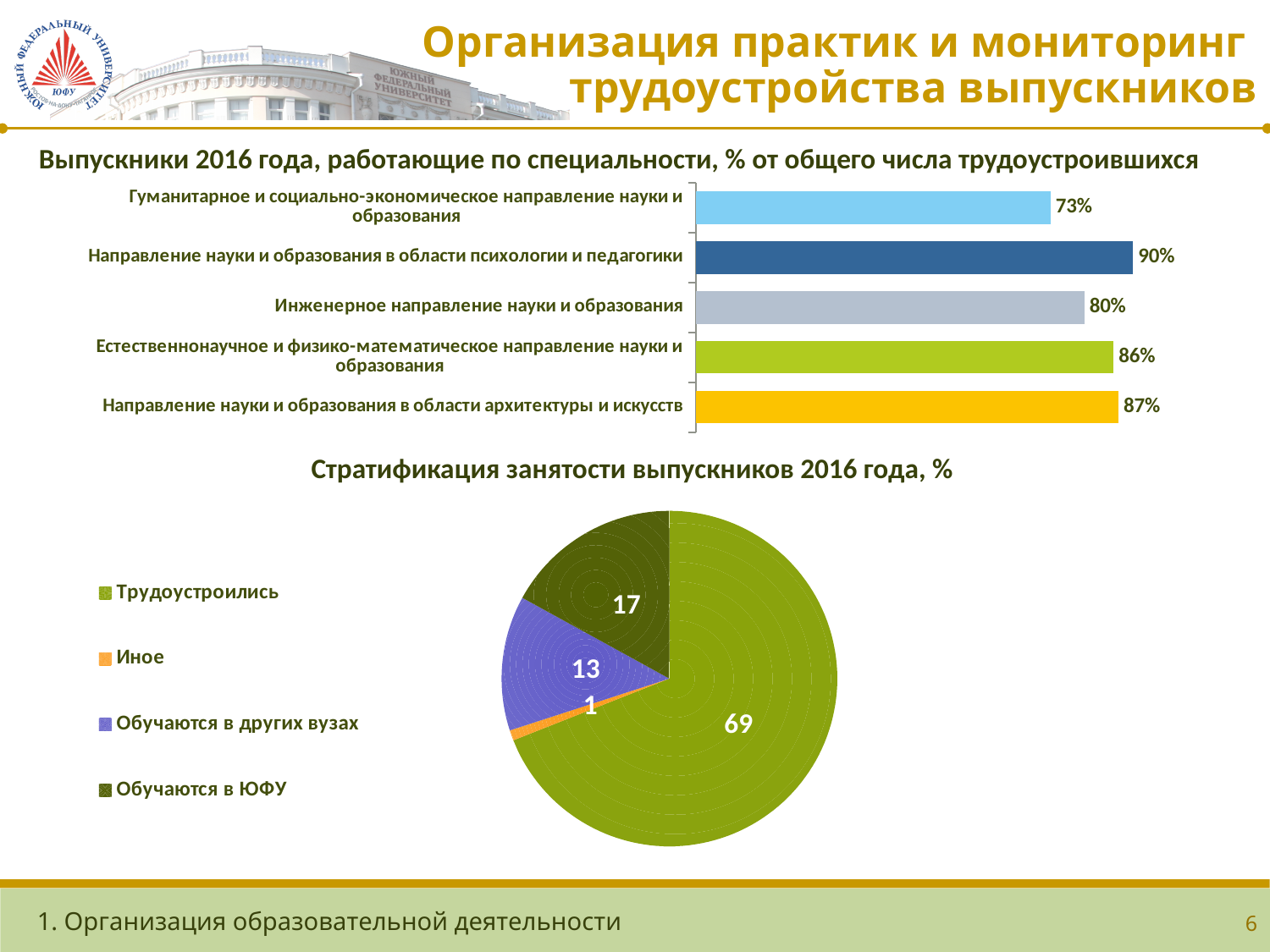
How many entries does the legend of the pie chart 'Стратификация занятости выпускников 2016 года, %' list? 4 In the bar chart 'Выпускники 2016 года, работающие по специальности', what is the value for 'Гуманитарное и социально-экономическое направление науки и образования'? 73% In the pie chart 'Стратификация занятости выпускников 2016 года, %', what is the value for 'Трудоустроились'? 69 In the bar chart 'Выпускники 2016 года, работающие по специальности', which category has the lowest value? Гуманитарное и социально-экономическое направление науки и образования In the bar chart 'Выпускники 2016 года, работающие по специальности', which is larger: the value for 'Естественнонаучное и физико-математическое направление науки и образования' or for 'Направление науки и образования в области архитектуры и искусств'? Направление науки и образования в области архитектуры и искусств In the bar chart 'Выпускники 2016 года, работающие по специальности', what is the value for 'Инженерное направление науки и образования'? 80% In the pie chart 'Стратификация занятости выпускников 2016 года, %', what is the value for 'Обучаются в ЮФУ'? 17 In the pie chart 'Стратификация занятости выпускников 2016 года, %', which category has the smallest slice? Иное What type of chart is the top chart 'Выпускники 2016 года, работающие по специальности'? Bar chart In the bar chart 'Выпускники 2016 года, работающие по специальности', which category has the highest value? Направление науки и образования в области психологии и педагогики In the bar chart 'Выпускники 2016 года, работающие по специальности', what is the difference between the values for 'Направление науки и образования в области психологии и педагогики' and 'Инженерное направление науки и образования'? 10% How many categories are shown in the bar chart 'Выпускники 2016 года, работающие по специальности'? 5